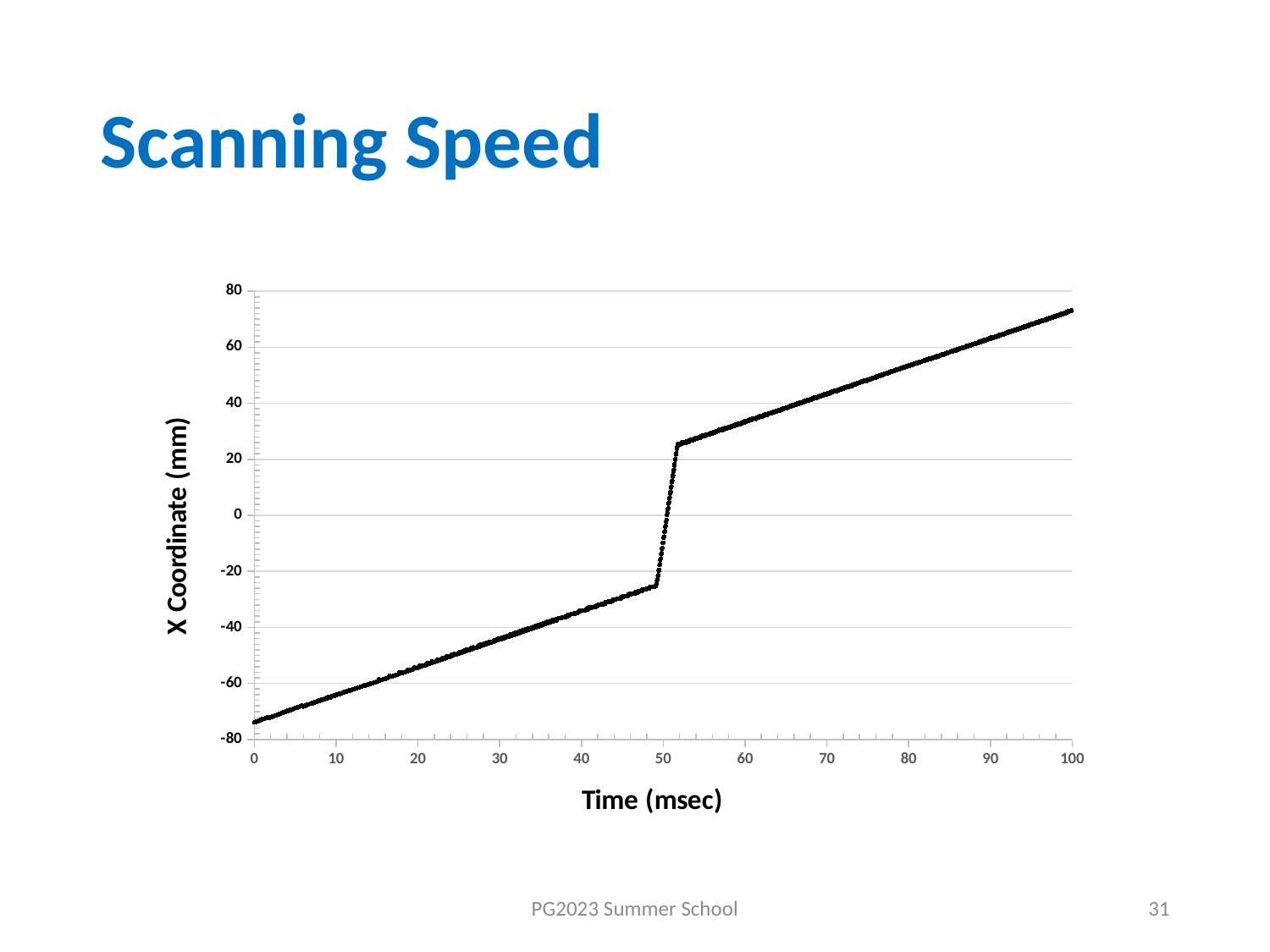
Is the X Coordinate value at Time 60 msec greater or less than 20? greater Do the X Coordinate values rise or fall as Time increases along the x axis? rise At which Time value is the X Coordinate at its lowest? 0 Is the X Coordinate value at Time 40 msec greater or less than -20? less At which Time value does the X Coordinate reach its highest point? 100 Is the X Coordinate value at Time 0 msec greater or less than -60? less What kind of chart is shown on the slide? scatter chart Which is larger, the X Coordinate at Time 30 msec or at Time 70 msec? Time 70 msec What is the title of the vertical axis? X Coordinate (mm)